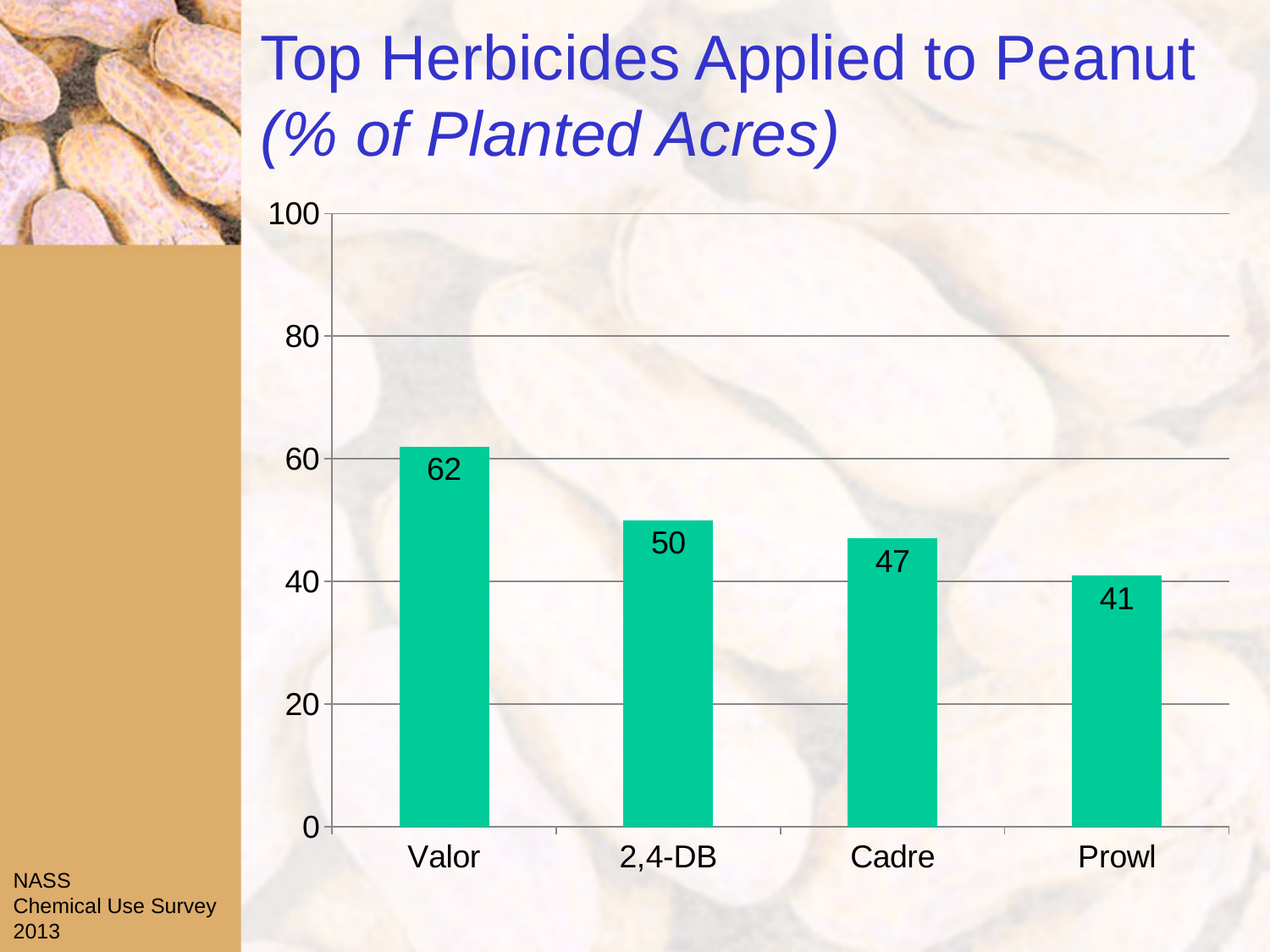
What is the difference between the values for Valor and Prowl? 21 Do the values rise or fall from left to right across the chart? Fall What is the value for Prowl? 41 What is the difference between the values for 2,4-DB and Cadre? 3 Which herbicide has the lowest value? Prowl Which is larger, the value for Cadre or the value for Prowl? Cadre What is the value for Valor? 62 What is the value for 2,4-DB? 50 What is the value for Cadre? 47 Which herbicide has the highest value? Valor How many herbicides are shown on the chart? 4 What kind of chart is shown on the slide? Bar chart